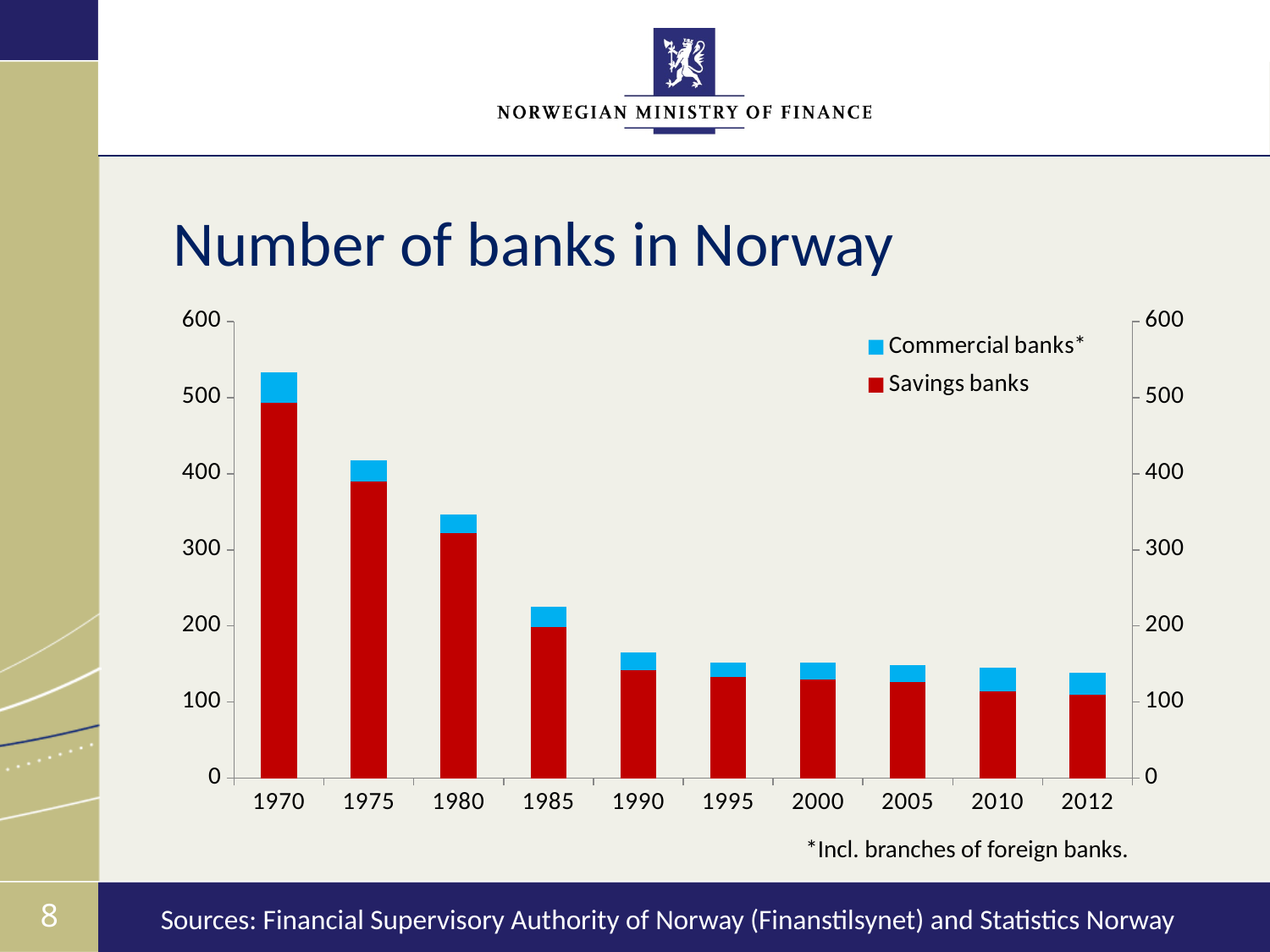
How many years are shown on the x axis? 10 Is the number of savings banks in 1980 greater or less than 300? greater Do the total number of banks rise or fall from 1970 to 2012? Fall Is the total number of banks in 1970 greater or less than 500? greater Is the total number of banks in 1990 greater or less than 200? less What is the title of the chart? Number of banks in Norway What kind of chart is shown on the slide? Stacked bar chart Which year has more savings banks, 1970 or 1975? 1970 How many series does the legend list? 2 Which year has the highest total number of banks? 1970 Which colour represents commercial banks in the chart? Blue